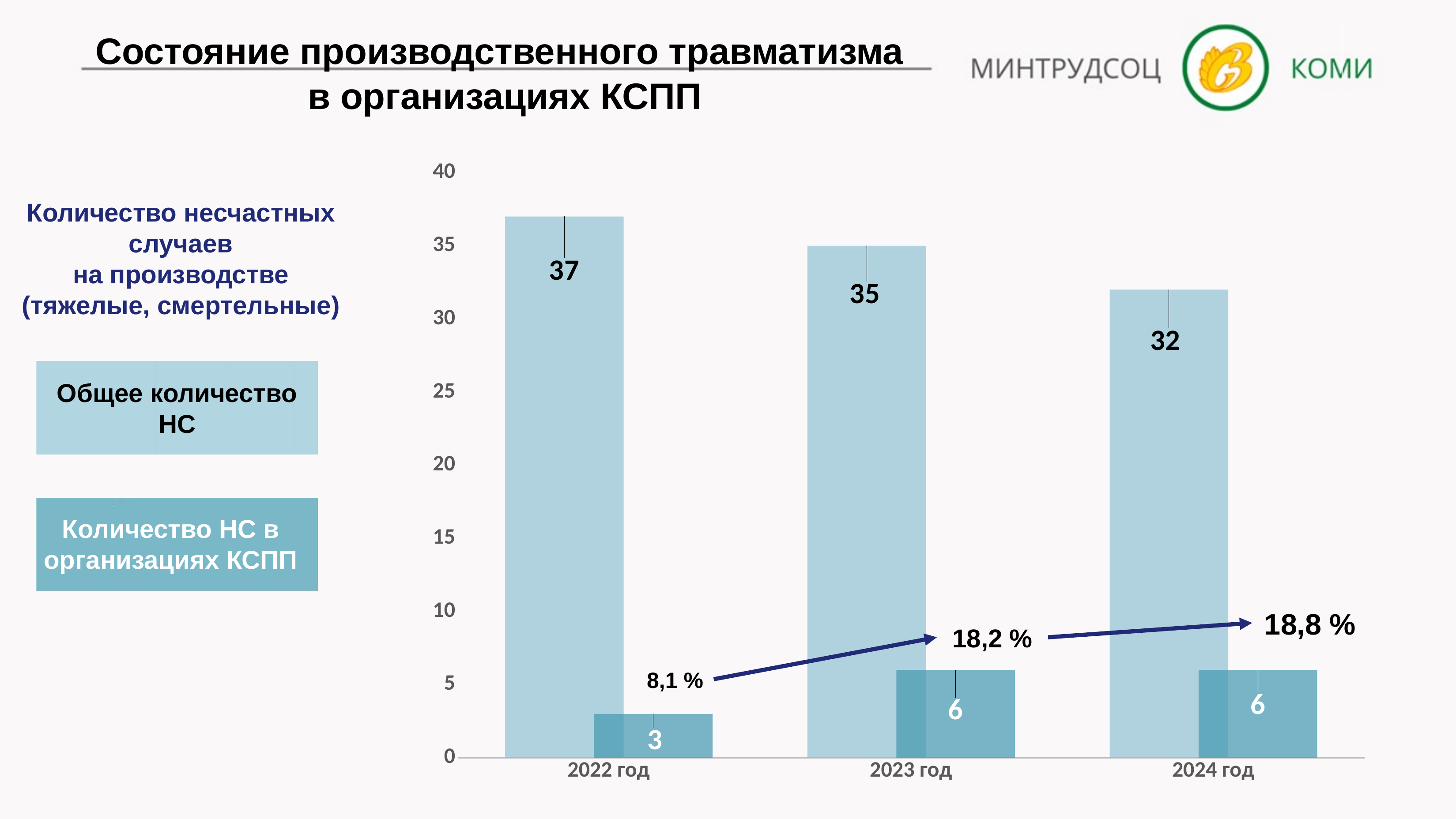
What is the difference between "Общее количество НС" in 2022 год and 2024 год? 5 What is the value of "Количество НС в организациях КСПП" for 2023 год? 6 In which year is "Количество НС в организациях КСПП" lowest? 2022 год What is the value of "Количество НС в организациях КСПП" for 2022 год? 3 How many series does the chart's legend list? 2 How many years are shown on the x axis of the chart? 3 What is the value of "Общее количество НС" for 2022 год? 37 Does "Общее количество НС" rise or fall from 2022 год to 2024 год? fall Which is larger: "Общее количество НС" in 2023 год or in 2024 год? 2023 год What is the value of "Общее количество НС" for 2024 год? 32 What kind of chart is shown on the slide? bar chart In which year is "Общее количество НС" highest? 2022 год